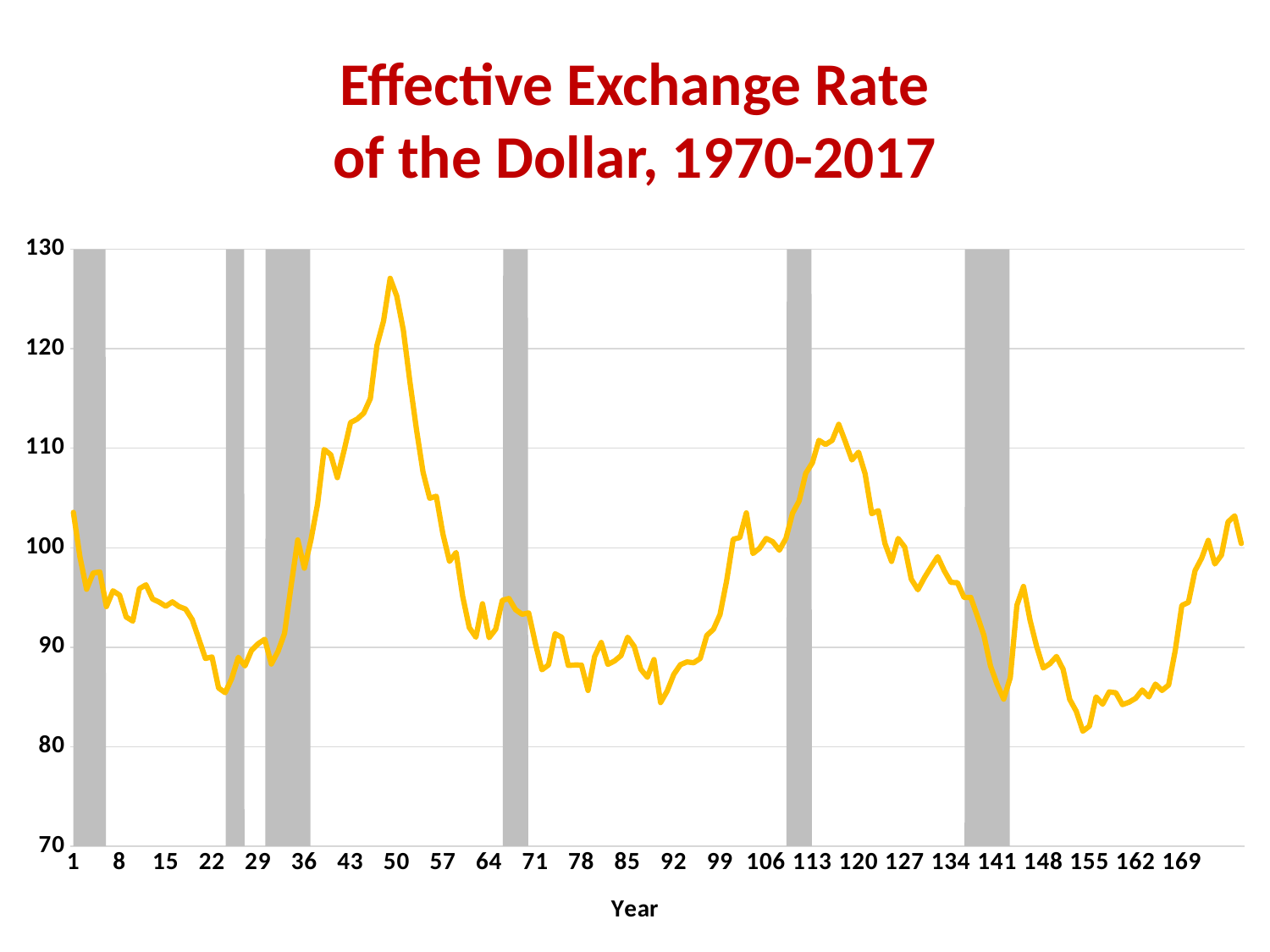
Around which x-axis tick does the line reach its highest value? 50 Does the line rise or fall between x = 36 and x = 50? rise What kind of chart is shown on the slide? line chart What is the highest value shown on the y axis? 130 What is the title of the chart? Effective Exchange Rate of the Dollar, 1970-2017 Is the value at x = 155 greater or less than 90? less Around which x-axis tick does the line reach its lowest value? 155 What is the label of the x axis? Year What is the lowest value shown on the y axis? 70 Is the value at x = 50 greater or less than 120? greater Does the line rise or fall between x = 50 and x = 64? fall Is the value at x = 1 greater or less than 100? greater